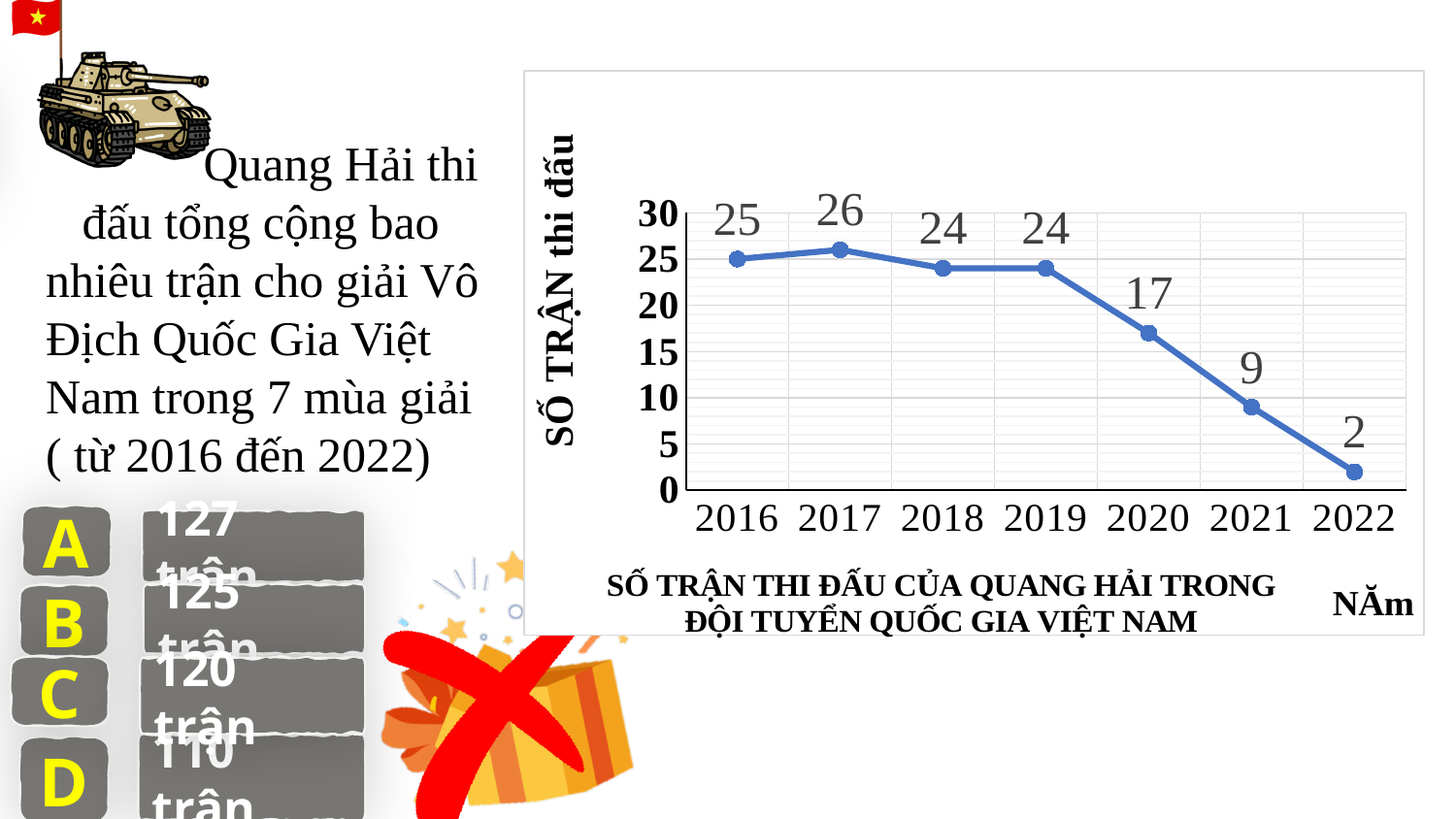
Is the value for 2021 greater or less than 10? less Do the values rise or fall from 2019 to 2022? fall What is the value for 2020? 17 What is the value for 2022? 2 Which is larger, the value for 2016 or the value for 2021? 2016 How many matches did Quang Hải play in 2017? 26 What is the label of the vertical axis? SỐ TRẬN thi đấu What type of chart is shown on the slide? line chart Which year has the highest number of matches? 2017 What is the difference between the values for 2019 and 2020? 7 How many years are plotted on the x axis? 7 Which year has the lowest number of matches? 2022